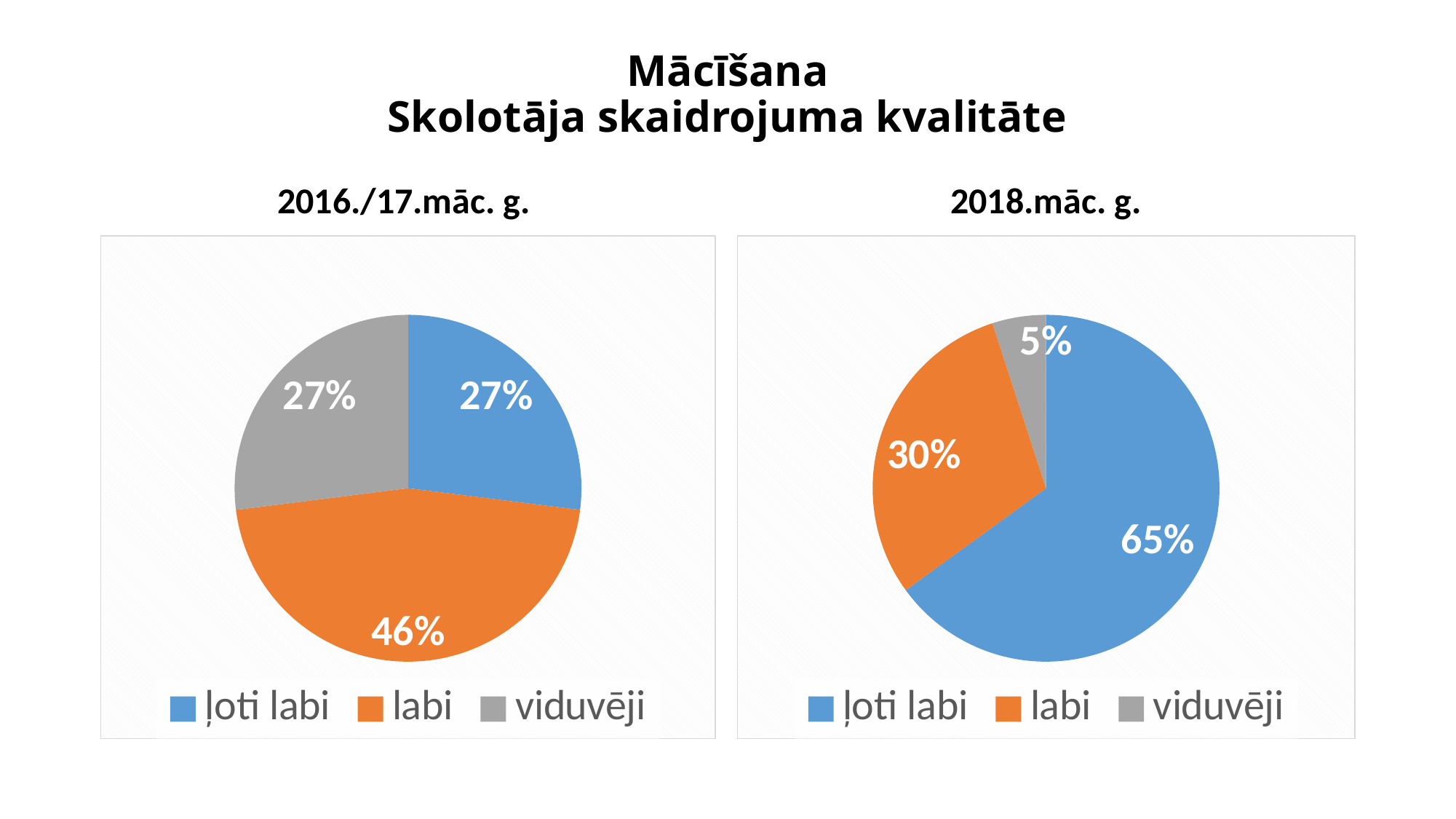
What type of chart is the 2016./17.māc. g. chart? pie chart In the 2018.māc. g. chart, what is the difference between the "ļoti labi" and "labi" shares? 35% In the 2016./17.māc. g. chart, what share does "labi" have? 46% In the 2018.māc. g. chart, which category has the largest slice? ļoti labi In the 2018.māc. g. chart, which colour represents "labi"? orange In the 2016./17.māc. g. chart, what share does "ļoti labi" have? 27% In the 2018.māc. g. chart, what share does "viduvēji" have? 5% Which is larger: the "labi" share in the 2016./17.māc. g. chart or the "labi" share in the 2018.māc. g. chart? 2016./17.māc. g. In the 2016./17.māc. g. chart, which category has the largest slice? labi In the 2018.māc. g. chart, which category has the smallest slice? viduvēji In the 2018.māc. g. chart, what share does "ļoti labi" have? 65% How many slices does the 2018.māc. g. pie chart have? 3